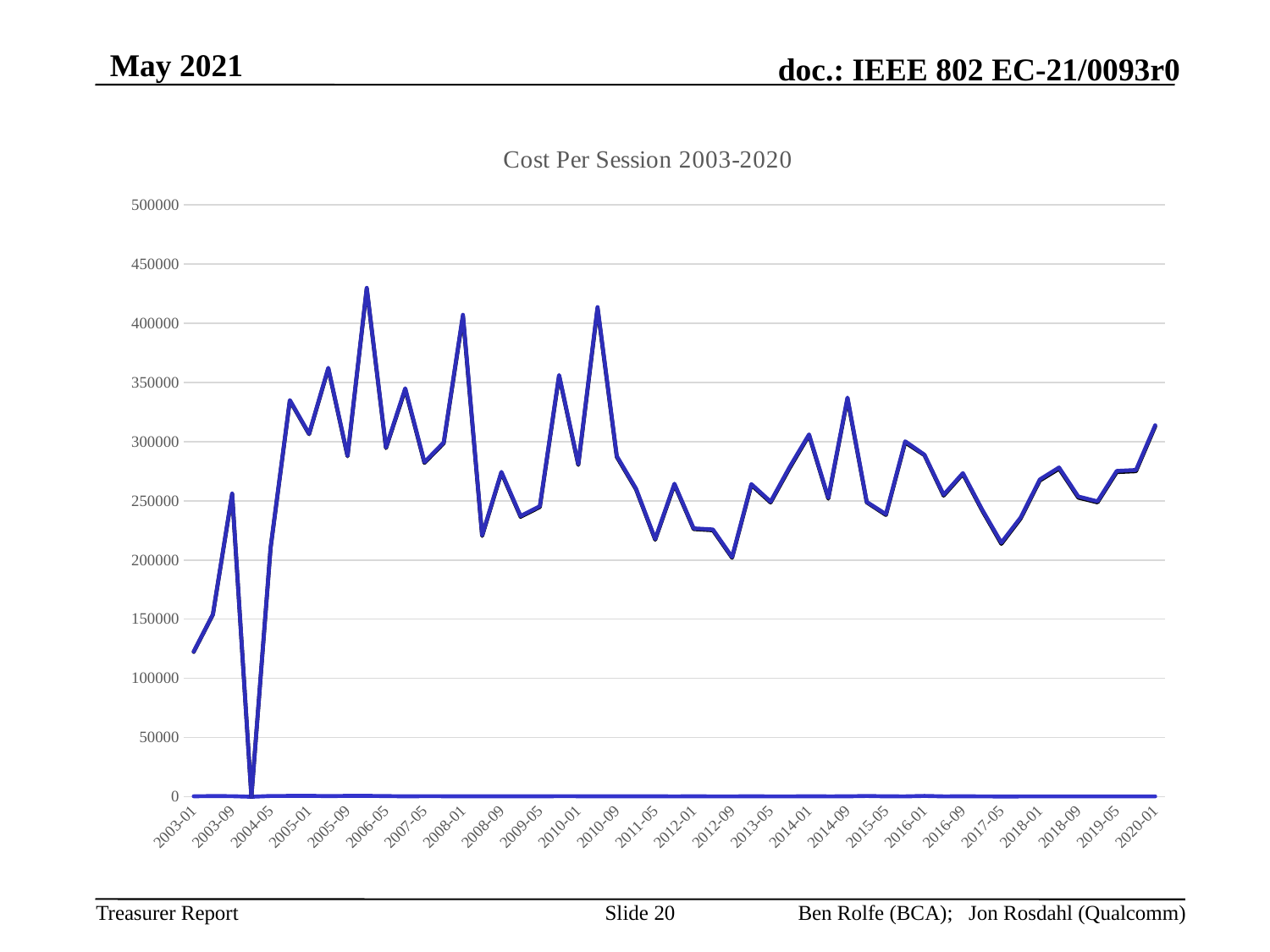
Is the value for 2012-09 greater or less than 250000? less What is the highest value shown on the y axis? 500000 What is the title of the chart? Cost Per Session 2003-2020 Which is larger, the value for 2014-09 or the value for 2017-05? 2014-09 Is the value for 2008-01 greater or less than 350000? greater Is the value for 2020-01 greater or less than 300000? greater Which is larger, the value for 2008-01 or the value for 2012-09? 2008-01 What type of chart is shown on the slide? Line chart